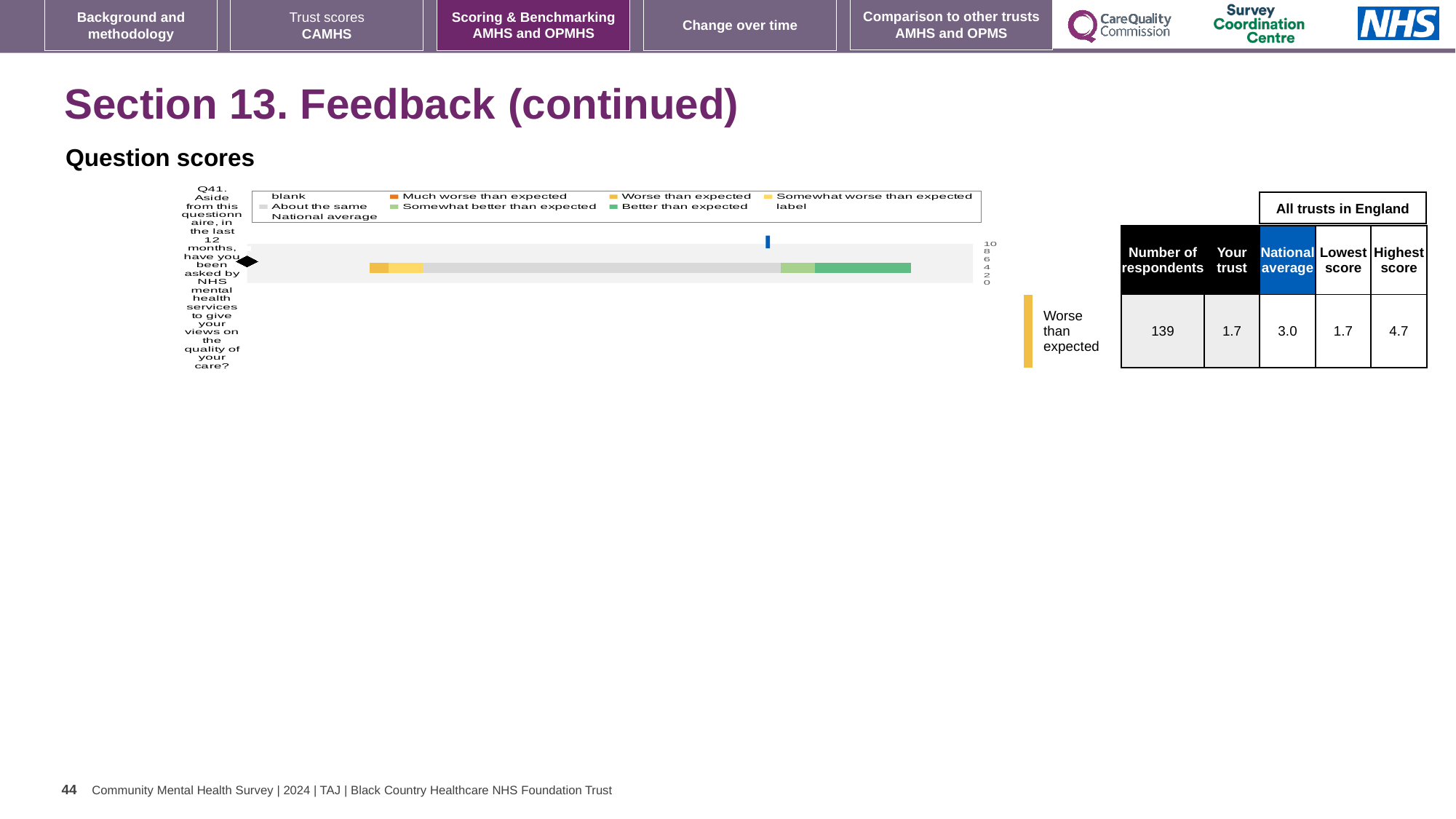
How many entries does the chart's legend list? 9 What benchmark rating is shown next to the chart for Q41? Worse than expected How many question categories are plotted in the chart? 1 What is the national average score for Q41? 3.0 What is the difference between the national average and the 'Your trust' score for Q41? 1.3 Which question number is plotted in the chart? Q41 Which is larger for Q41, the 'Your trust' score or the national average? National average What is the lowest score among all trusts in England for Q41? 1.7 What is the 'Your trust' score for Q41? 1.7 What is the highest score among all trusts in England for Q41? 4.7 What kind of chart is shown on the slide? Bar chart How many respondents answered Q41? 139